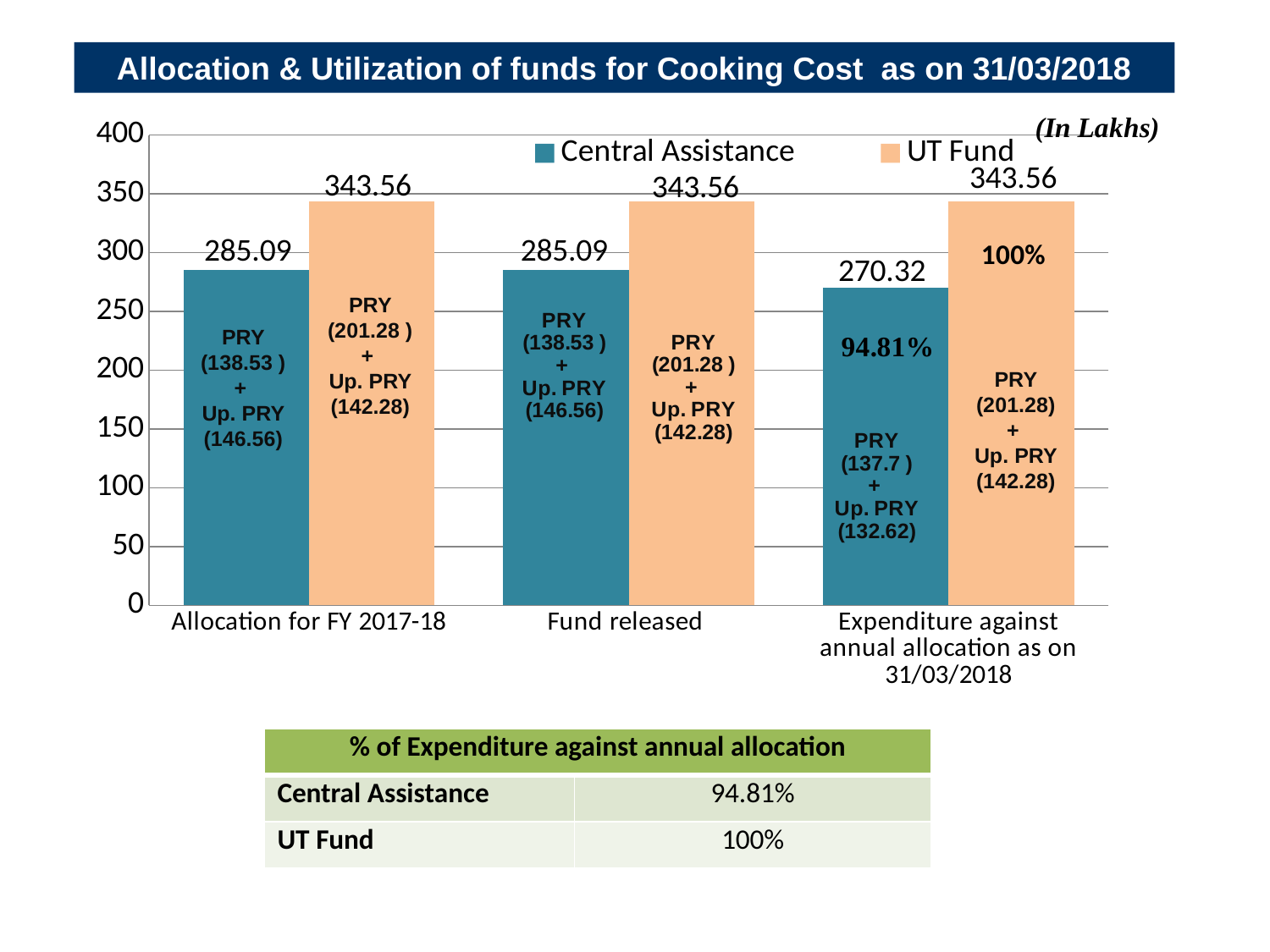
Is the Central Assistance value for Expenditure against annual allocation as on 31/03/2018 greater or less than 300? less Which is larger for Fund released: Central Assistance or UT Fund? UT Fund What kind of chart is shown on the slide? bar chart How many categories are shown on the x axis? 3 What is the difference between the UT Fund and Central Assistance values for Allocation for FY 2017-18? 58.47 What is the difference between the Central Assistance values for Fund released and Expenditure against annual allocation as on 31/03/2018? 14.77 What is the Central Assistance value for Allocation for FY 2017-18? 285.09 What is the UT Fund value for Fund released? 343.56 Which category has the lowest Central Assistance value? Expenditure against annual allocation as on 31/03/2018 What is the Central Assistance value for Expenditure against annual allocation as on 31/03/2018? 270.32 What unit is stated for the values in the chart? In Lakhs How many series does the legend list? 2